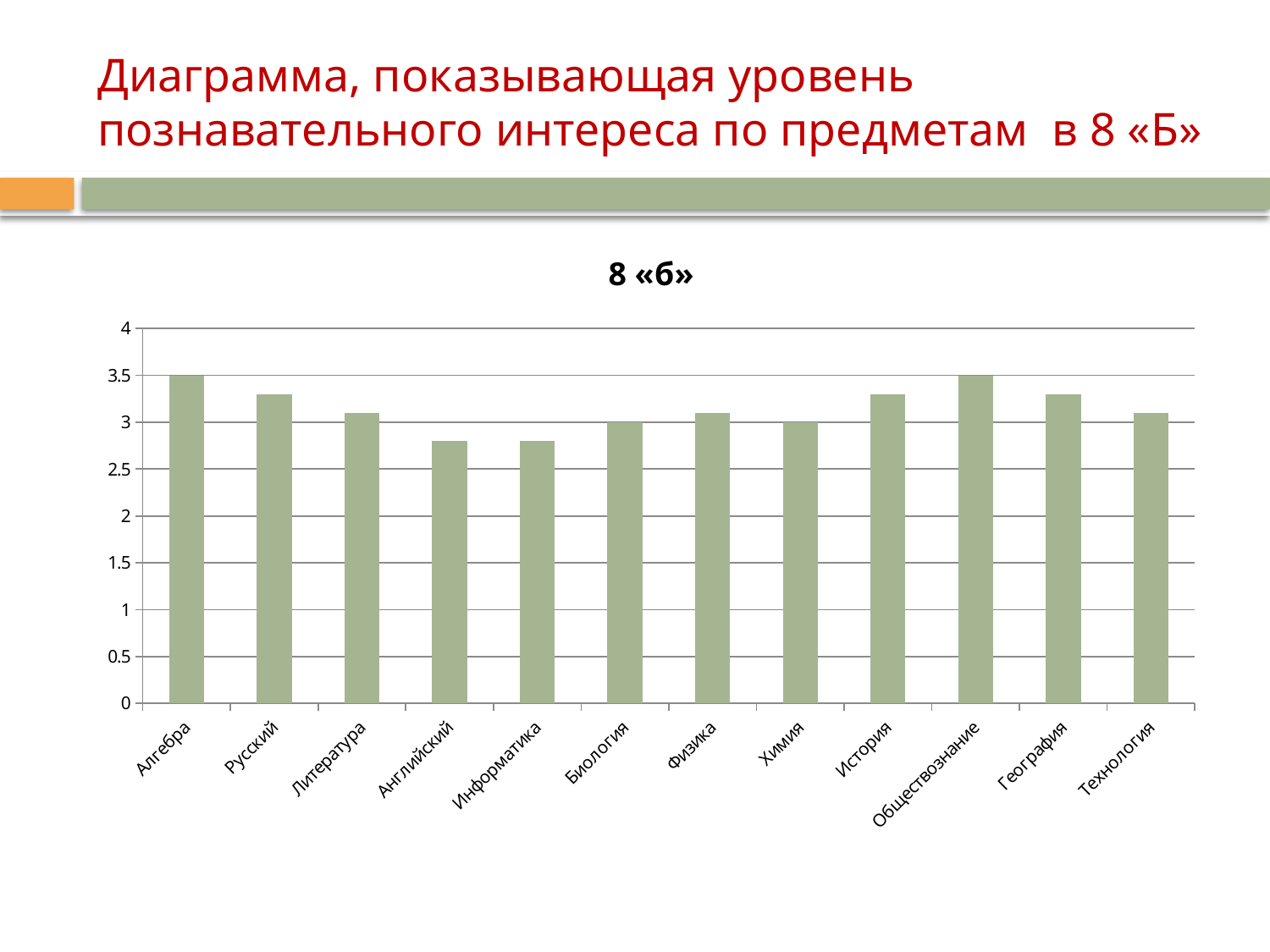
Is the value for История greater or less than 3? greater What is the title of the chart? 8 «б» What type of chart is shown on the slide? bar chart Is the value for Английский greater or less than 3? less What is the value for Обществознание? 3.5 Which is larger, the value for Алгебра or the value for Английский? Алгебра Which is larger, the value for Русский or the value for Биология? Русский What is the value for Алгебра? 3.5 What is the value for Биология? 3 How many subjects (categories) are shown on the x axis of the chart? 12 What is the value for Химия? 3 Is the value for Информатика greater or less than 3? less